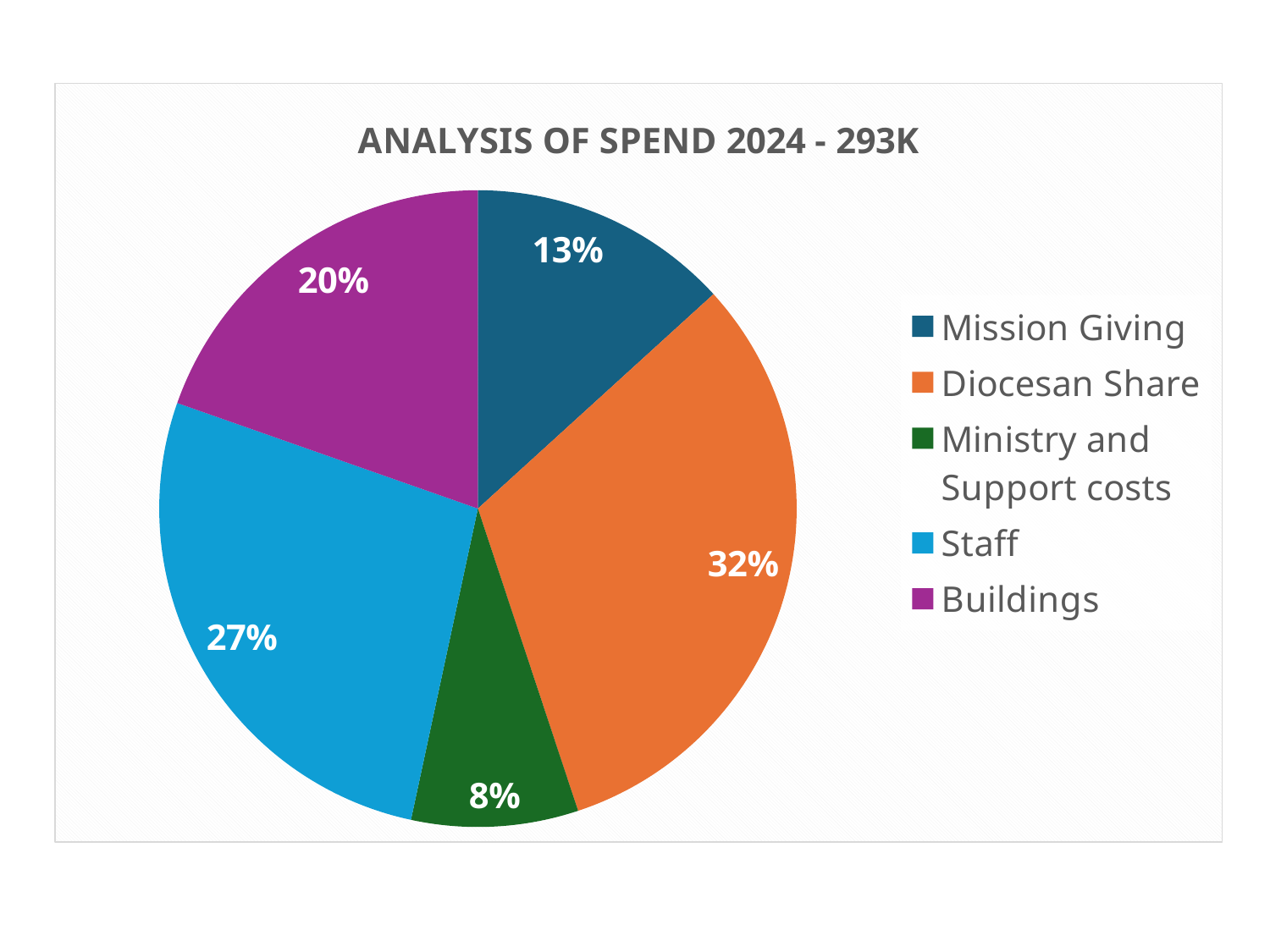
What share of spend is Diocesan Share? 32% What share of spend is Staff? 27% Which category has the largest share of spend? Diocesan Share What share of spend is Ministry and Support costs? 8% What is the title of the chart? ANALYSIS OF SPEND 2024 - 293K Which is larger, the share for Mission Giving or the share for Buildings? Buildings Which category has the smallest share of spend? Ministry and Support costs What is the difference in percentage points between Staff and Buildings? 7 percentage points What kind of chart is shown on the slide? Pie chart How many categories does the pie chart show? 5